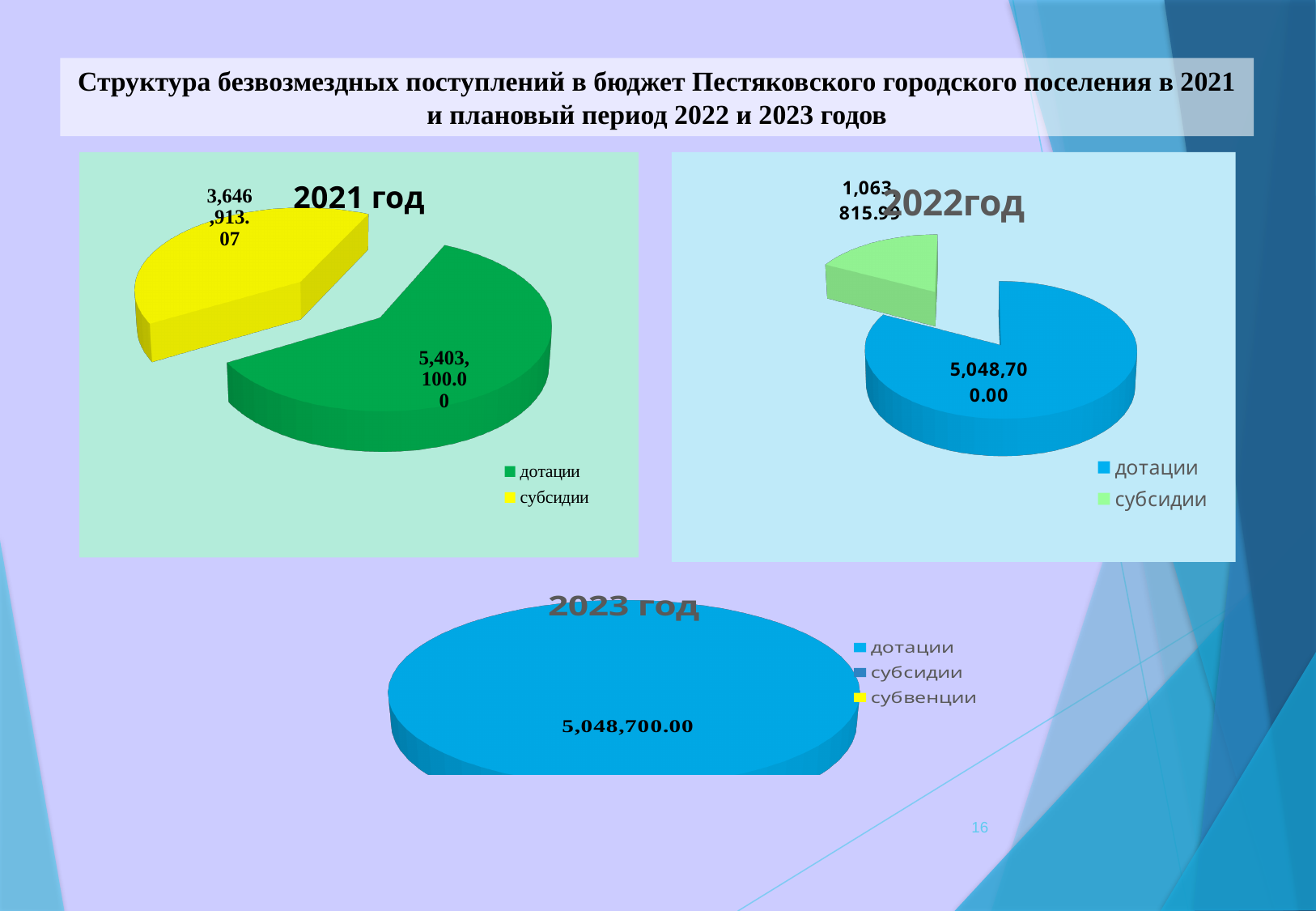
How many entries does the legend of the "2022год" chart list? 2 In the "2021 год" chart, what is the value for дотации? 5,403,100.00 In the "2021 год" chart, what is the total of the two slices? 9,050,013.07 What kind of chart is the "2021 год" chart? pie chart In the "2021 год" chart, what is the value for субсидии? 3,646,913.07 In the "2022год" chart, which category has the smallest slice? субсидии In the "2021 год" chart, which category has the largest slice? дотации How many entries does the legend of the "2023 год" chart list? 3 Is the value for дотации larger in the "2021 год" chart or in the "2022год" chart? 2021 год In the "2021 год" chart, what is the difference between дотации and субсидии? 1,756,186.93 In the "2022год" chart, what is the value for дотации? 5,048,700.00 In the "2023 год" chart, what is the value for дотации? 5,048,700.00